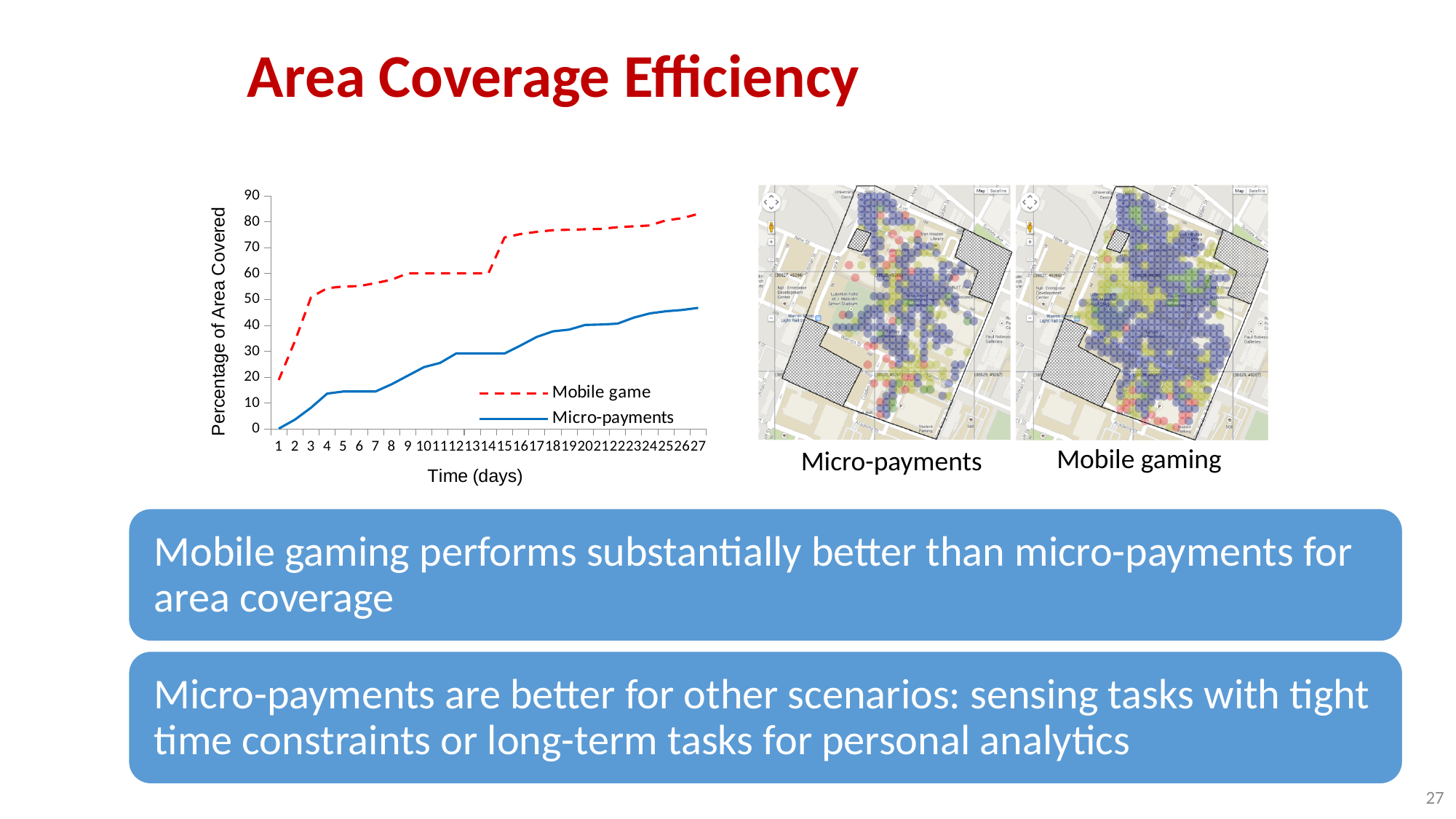
Is the value for Micro-payments on day 20 greater or less than 30? greater What is the label of the y axis of the line chart? Percentage of Area Covered How many days are shown along the x axis of the line chart? 27 Is the value for Micro-payments on day 27 greater or less than 50? less Do the values for Micro-payments rise or fall over time in the line chart? rise Is the value for Mobile game on day 27 greater or less than 80? greater How many series does the legend of the line chart list? 2 Which series is drawn as a red dashed line in the line chart? Mobile game What kind of chart is shown on the left of the slide? line chart Which series has the higher percentage of area covered on day 10 in the line chart? Mobile game